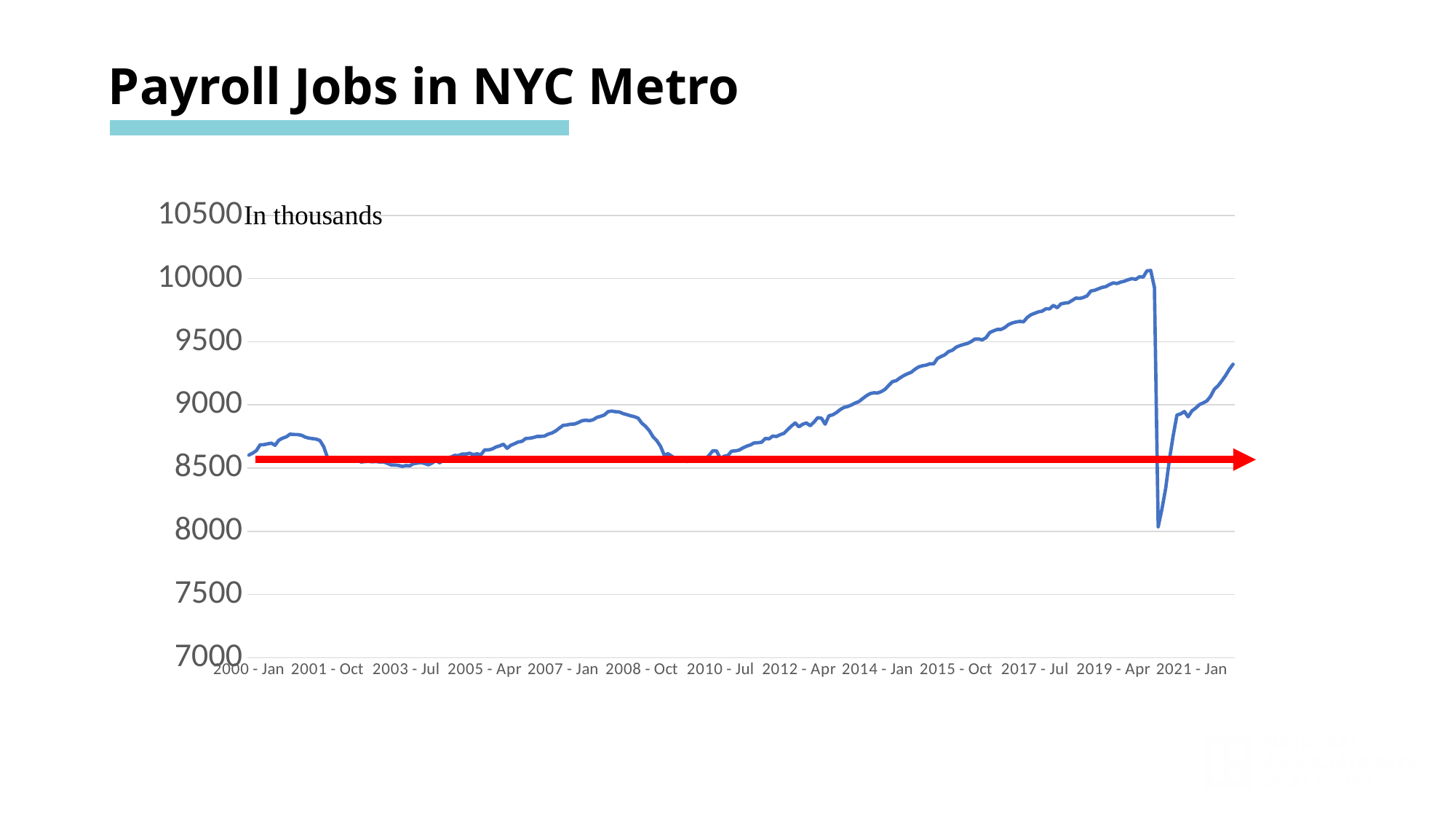
Does the line generally rise or fall between 2010 - Jul and 2019 - Apr? rise What is the title of the chart on the slide? Payroll Jobs in NYC Metro What kind of chart is shown on the slide? line chart Is the value at 2017 - Jul greater or less than 9500? greater In what units are the values on the chart expressed, according to the label near the top of the y axis? In thousands Is the lowest point of the line greater or less than 8500? less Is the final point of the line (after 2021 - Jan) greater or less than 9000? greater How many data series are plotted on the chart? 1 What is the highest value shown on the y axis? 10500